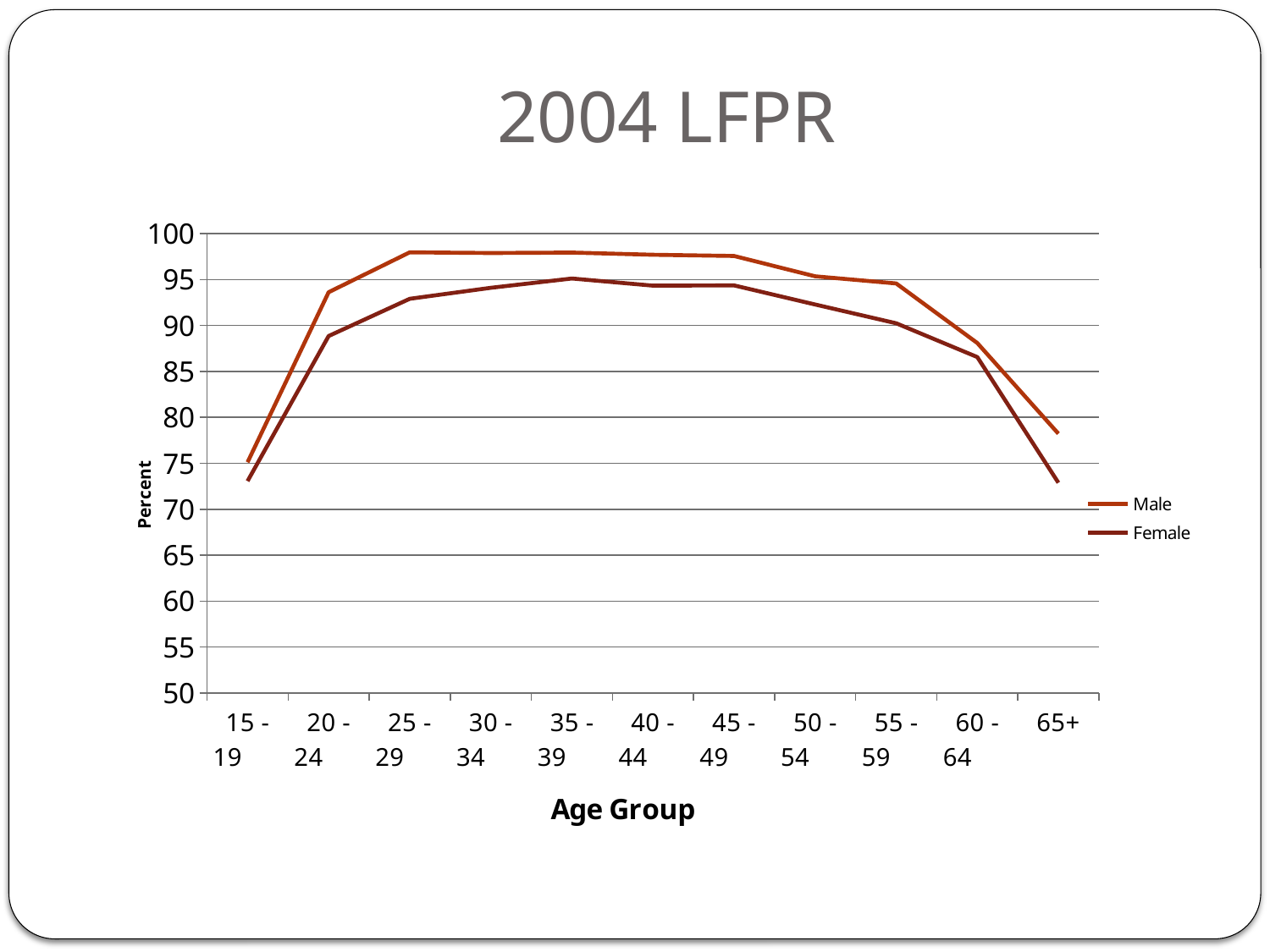
What is the title of the chart? 2004 LFPR What kind of chart is shown on the slide? line chart Is the Male value for the 15 - 19 age group greater or less than 80? less For the Male series, which age group has the lowest value? 15 - 19 Do the Male values rise or fall from the 55 - 59 age group to the 65+ age group? fall Is the Male value for the 65+ age group greater or less than 80? less Is the Female value for the 20 - 24 age group greater or less than 90? less How many series does the legend list? 2 How many age groups are plotted along the x axis? 11 Which series has the higher value for the 40 - 44 age group, Male or Female? Male